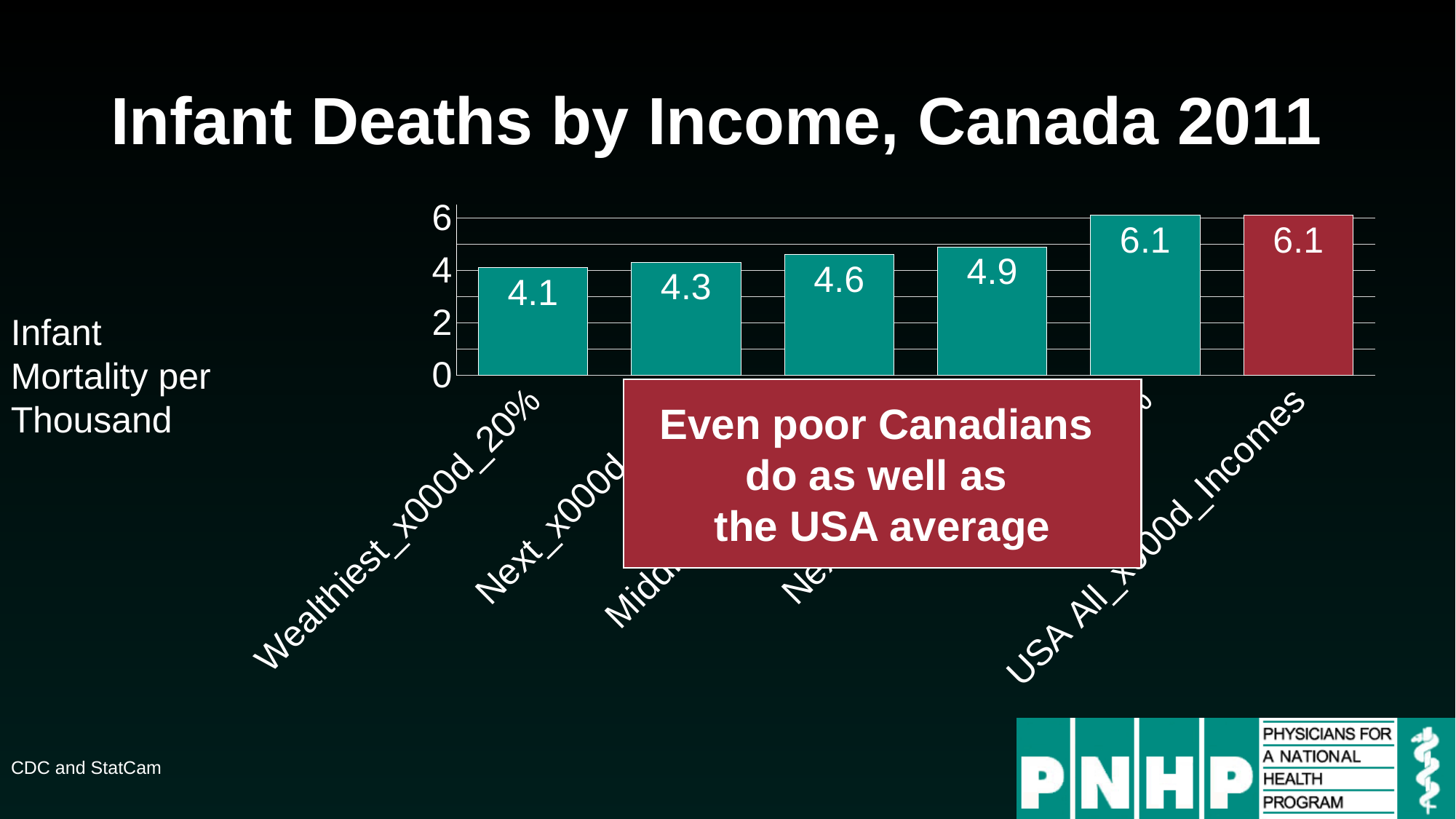
Which is larger, the value for USA All Incomes or the value for Wealthiest 20%? USA All Incomes What is the infant mortality value for the Wealthiest 20% category? 4.1 What is the highest value shown on any bar in the chart? 6.1 What kind of chart is shown on the slide? bar chart What is the difference between the USA All Incomes value and the Wealthiest 20% value? 2.0 What value is shown on the third bar from the left? 4.6 What value is shown on the second bar from the left? 4.3 What value is shown on the fourth bar from the left? 4.9 Is the value for Wealthiest 20% greater or less than 6? less Which category has the lowest infant mortality value? Wealthiest 20% How many bars are plotted in the chart? 6 What is the infant mortality value for the USA All Incomes category? 6.1